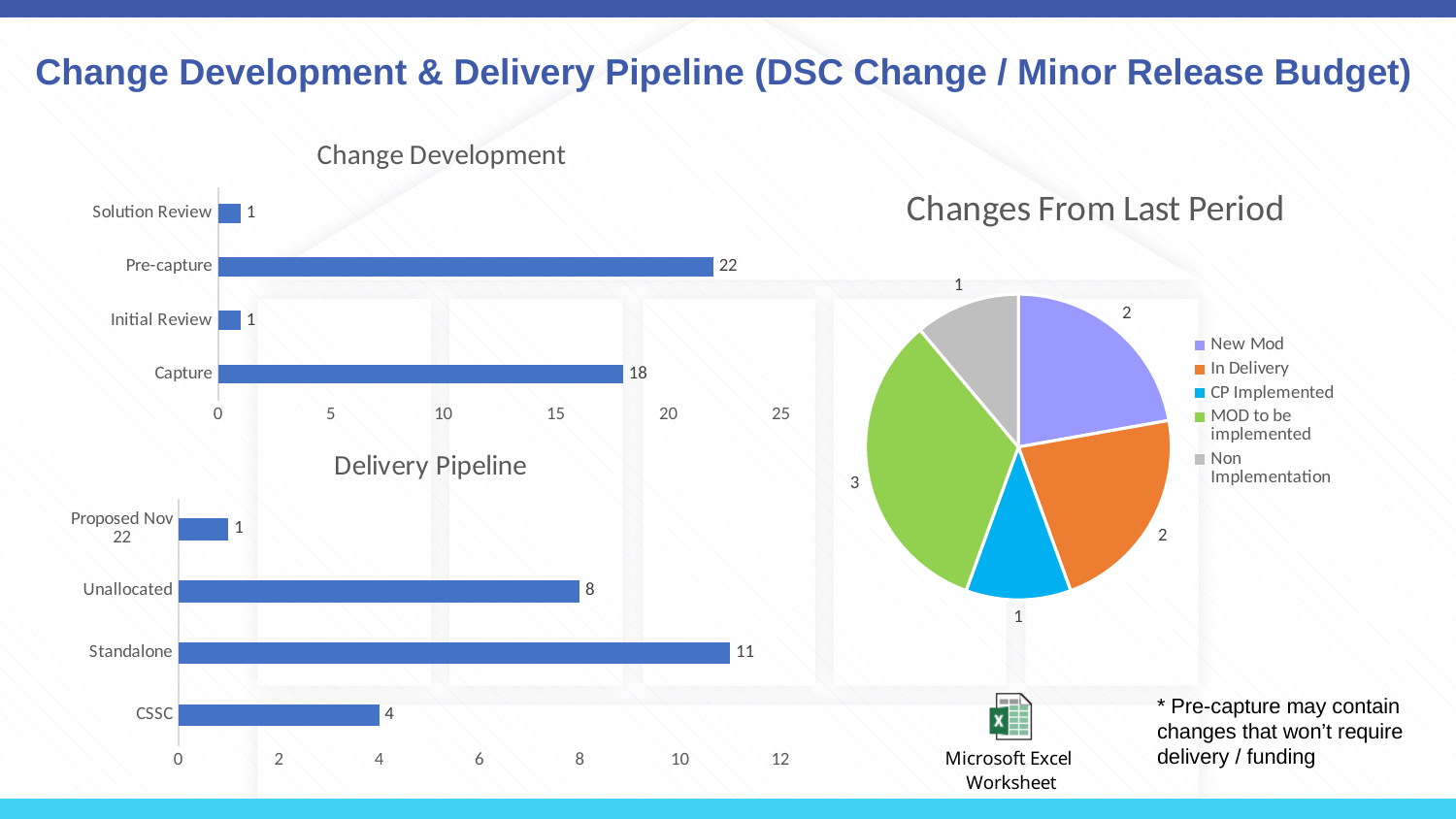
In the Change Development chart, which category has the highest value? Pre-capture In the Delivery Pipeline chart, which is larger, Unallocated or CSSC? Unallocated In the Change Development chart, what is the value for Capture? 18 In the Change Development chart, what is the value for Pre-capture? 22 In the Change Development chart, how many categories are shown? 4 In the Changes From Last Period pie chart, what is the value for MOD to be implemented? 3 In the Change Development chart, what is the difference between Pre-capture and Capture? 4 In the Delivery Pipeline chart, which category has the lowest value? Proposed Nov 22 In the Delivery Pipeline chart, what is the value for Standalone? 11 How many entries does the legend of the Changes From Last Period chart list? 5 What kind of chart is the Delivery Pipeline chart? Bar chart In the Delivery Pipeline chart, what is the value for CSSC? 4